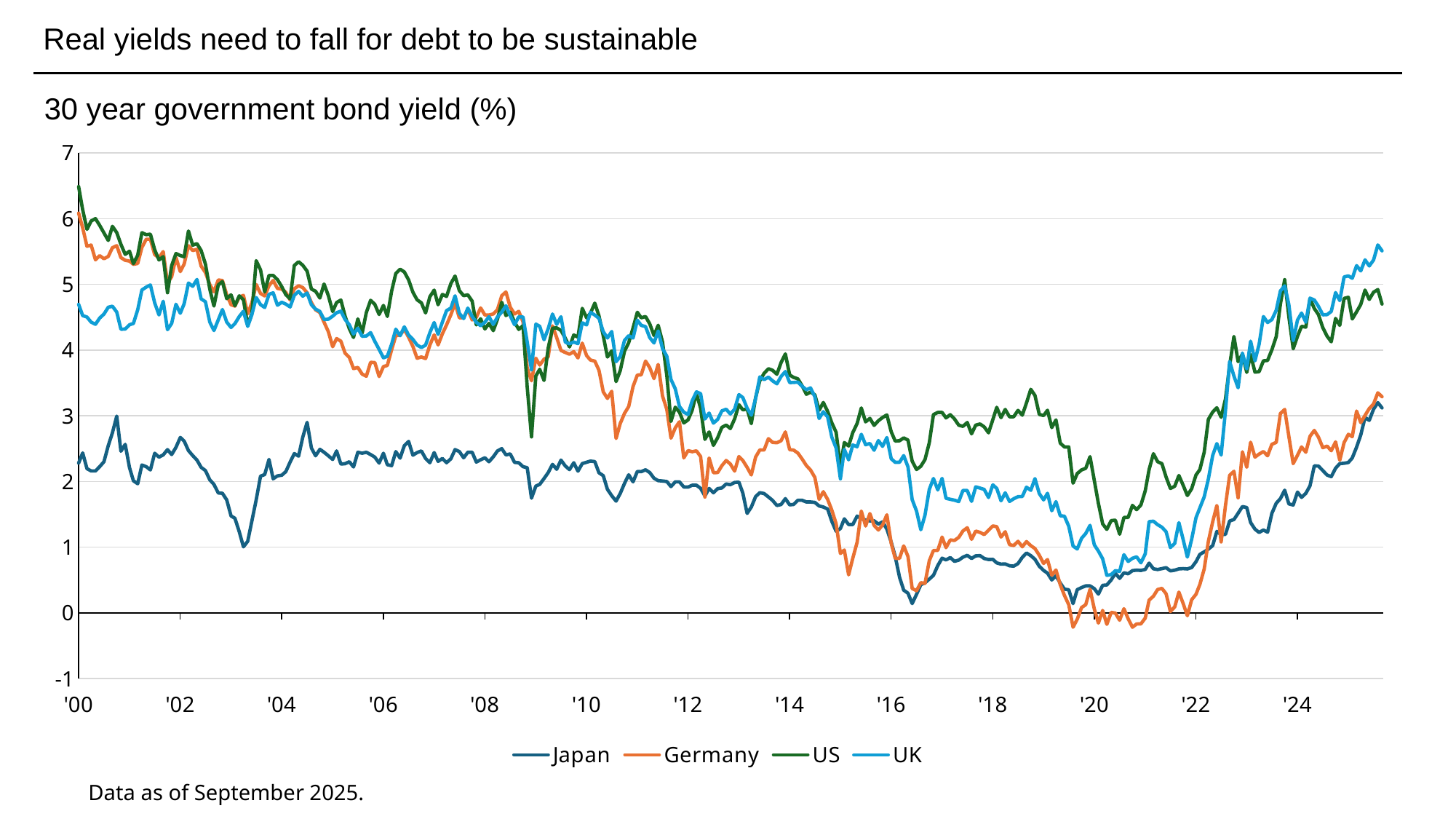
Which series has the lowest yield at the start of 2000? Japan At the start of 2000, which is higher, the US yield or the Japan yield? US What is the title of the slide above the chart? Real yields need to fall for debt to be sustainable Which series are listed in the legend? Japan, Germany, US, UK Is the value for Germany around 2020 greater or less than 1? less Does the Japan yield generally rise or fall from 2000 to 2016? fall Which series has the highest yield at the end of the chart in 2025? UK Is the value for Japan at the start of 2000 greater or less than 3? less How many series does the legend list? 4 Does the Germany yield generally rise or fall from 2022 to 2025? rise Is the value for US at the start of 2000 greater or less than 6? greater What kind of chart is shown on the slide? line chart